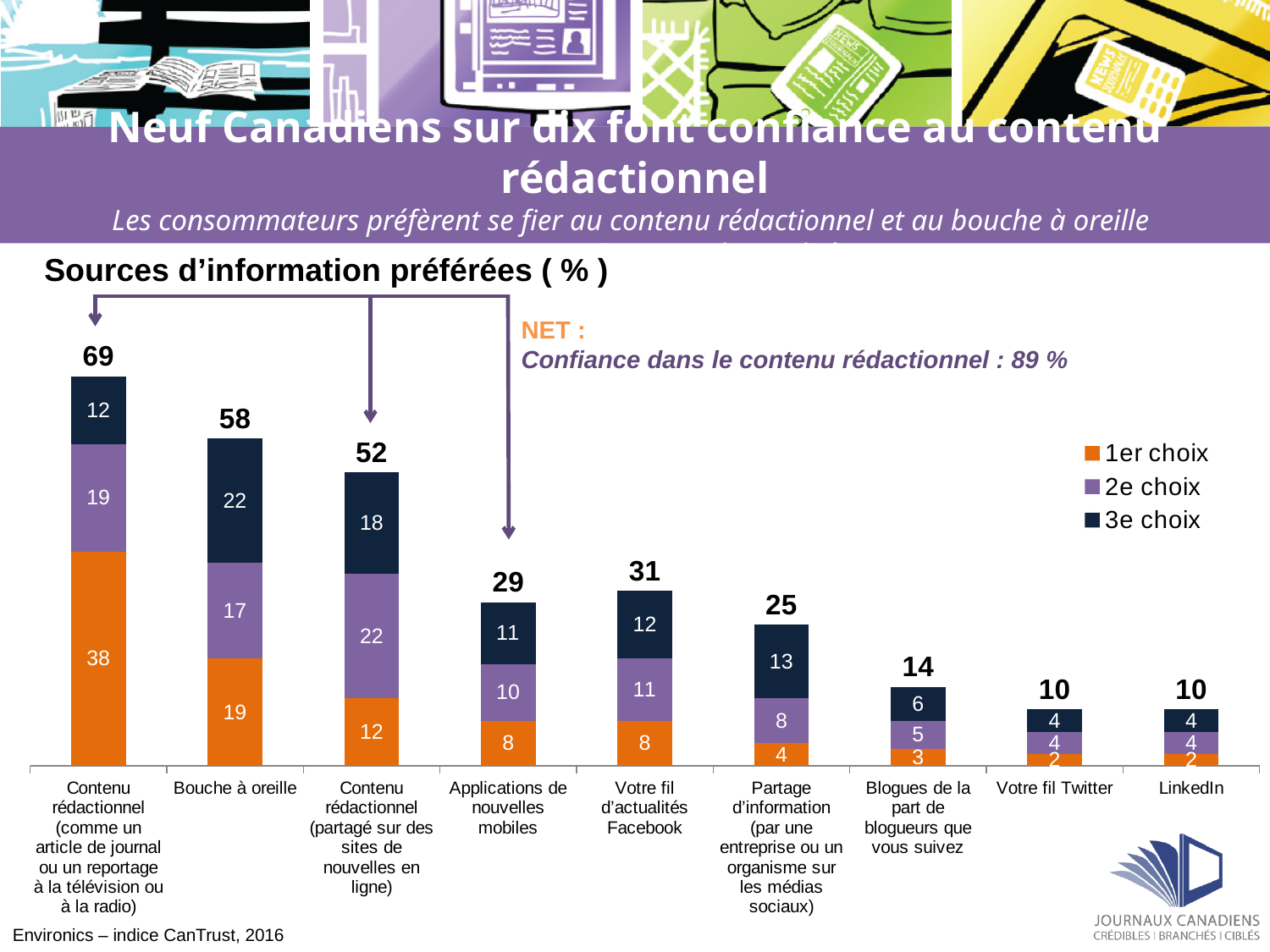
What is the total value for Blogues de la part de blogueurs que vous suivez? 14 What is the total value for Bouche à oreille? 58 How many categories are shown on the x axis? 9 What is the 1er choix value for Contenu rédactionnel (comme un article de journal ou un reportage à la télévision ou à la radio)? 38 What is the 3e choix value for Partage d'information (par une entreprise ou un organisme sur les médias sociaux)? 13 Which has a larger total, Bouche à oreille or Contenu rédactionnel (partagé sur des sites de nouvelles en ligne)? Bouche à oreille What is the title of the chart? Sources d'information préférées ( % ) What type of chart is shown on the slide? Stacked bar chart Which category has the highest total? Contenu rédactionnel (comme un article de journal ou un reportage à la télévision ou à la radio) What is the 2e choix value for Contenu rédactionnel (partagé sur des sites de nouvelles en ligne)? 22 How many series does the legend list? 3 What is the difference between the totals for Votre fil d'actualités Facebook and Applications de nouvelles mobiles? 2